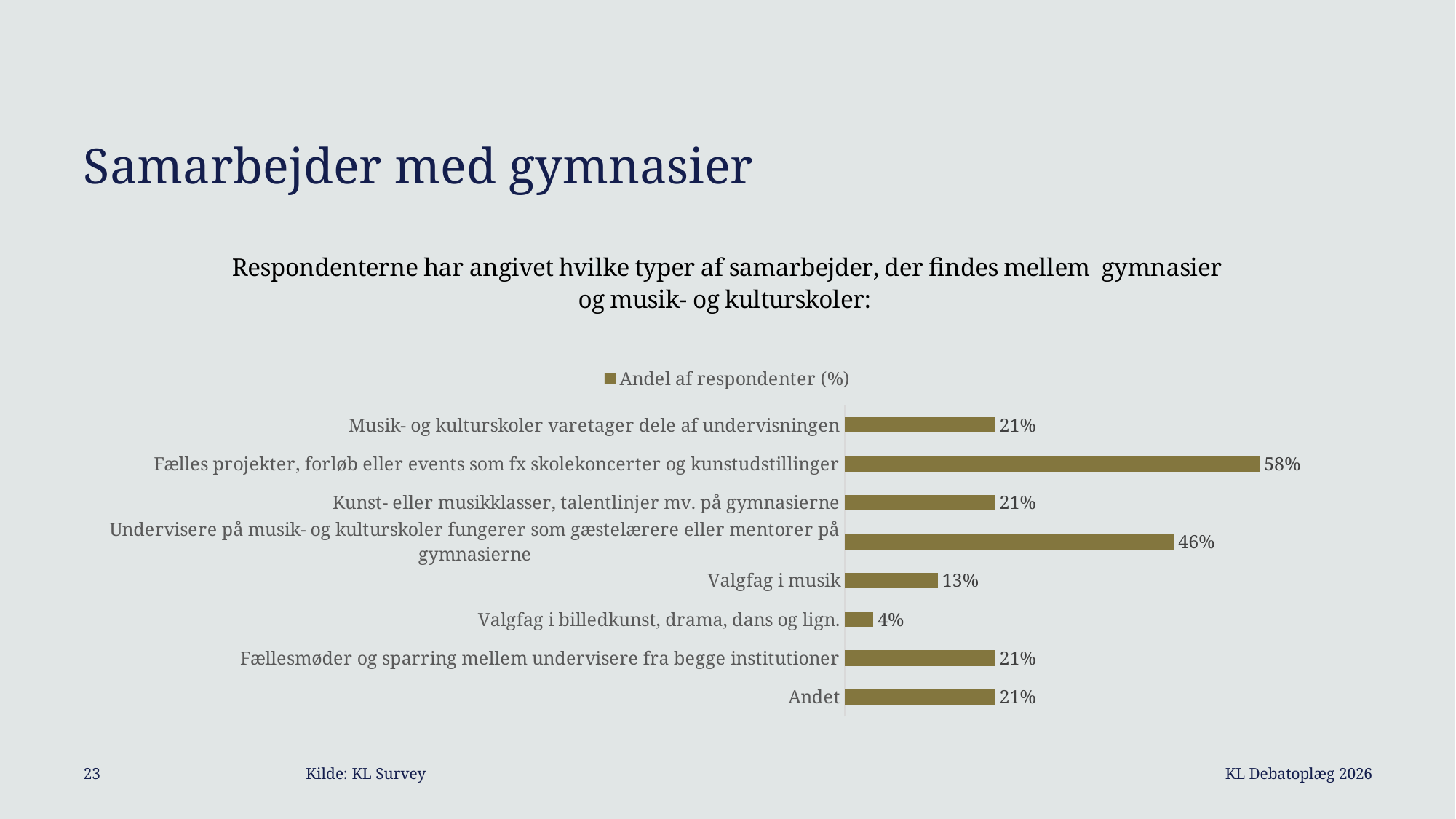
How many series does the legend list? 1 What is the value for "Fælles projekter, forløb eller events som fx skolekoncerter og kunstudstillinger"? 58% What is the value for "Undervisere på musik- og kulturskoler fungerer som gæstelærere eller mentorer på gymnasierne"? 46% Which is larger: the value for "Valgfag i musik" or the value for "Fællesmøder og sparring mellem undervisere fra begge institutioner"? Fællesmøder og sparring mellem undervisere fra begge institutioner What is the difference between the values for "Fælles projekter, forløb eller events som fx skolekoncerter og kunstudstillinger" and "Undervisere på musik- og kulturskoler fungerer som gæstelærere eller mentorer på gymnasierne"? 12% How many categories are shown in the chart? 8 What is the difference between the values for "Valgfag i musik" and "Valgfag i billedkunst, drama, dans og lign."? 9% What is the value for "Andet"? 21% What kind of chart is shown on the slide? Bar chart Which category has the highest value? Fælles projekter, forløb eller events som fx skolekoncerter og kunstudstillinger What is the value for "Valgfag i musik"? 13% Which category has the lowest value? Valgfag i billedkunst, drama, dans og lign.